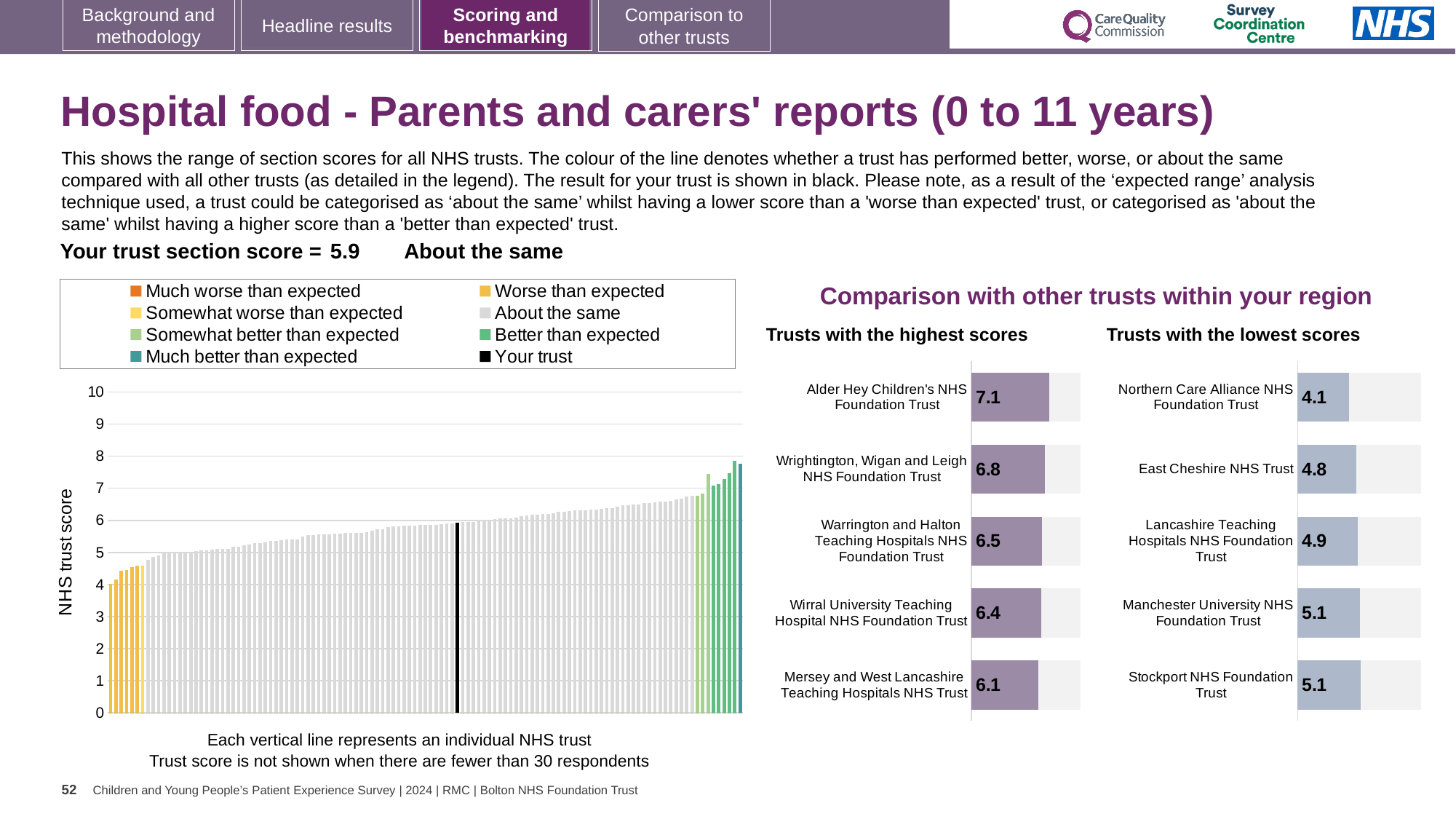
How many entries does the legend above the main 'NHS trust score' chart list? 8 In the 'Trusts with the highest scores' chart, which trust has the lowest score? Mersey and West Lancashire Teaching Hospitals NHS Trust In the main 'NHS trust score' chart on the left, do the bar values rise or fall from left to right? rise In the 'Trusts with the highest scores' chart, which has the higher score: Warrington and Halton Teaching Hospitals NHS Foundation Trust or Wirral University Teaching Hospital NHS Foundation Trust? Warrington and Halton Teaching Hospitals NHS Foundation Trust In the 'Trusts with the highest scores' chart, what is the score for Alder Hey Children's NHS Foundation Trust? 7.1 In the 'Trusts with the highest scores' chart, what is the difference between the scores of Alder Hey Children's NHS Foundation Trust and Mersey and West Lancashire Teaching Hospitals NHS Trust? 1.0 In the 'Trusts with the lowest scores' chart, which trust has the lowest score? Northern Care Alliance NHS Foundation Trust In the 'Trusts with the lowest scores' chart, what is the score for East Cheshire NHS Trust? 4.8 In the main 'NHS trust score' chart on the left, is the value of the tallest bar greater or less than 7? greater What kind of chart is the main 'NHS trust score' chart on the left? bar chart In the 'Trusts with the lowest scores' chart, how many trusts are listed? 5 In the main 'NHS trust score' chart on the left, what is the score for your trust (the black bar)? 5.9